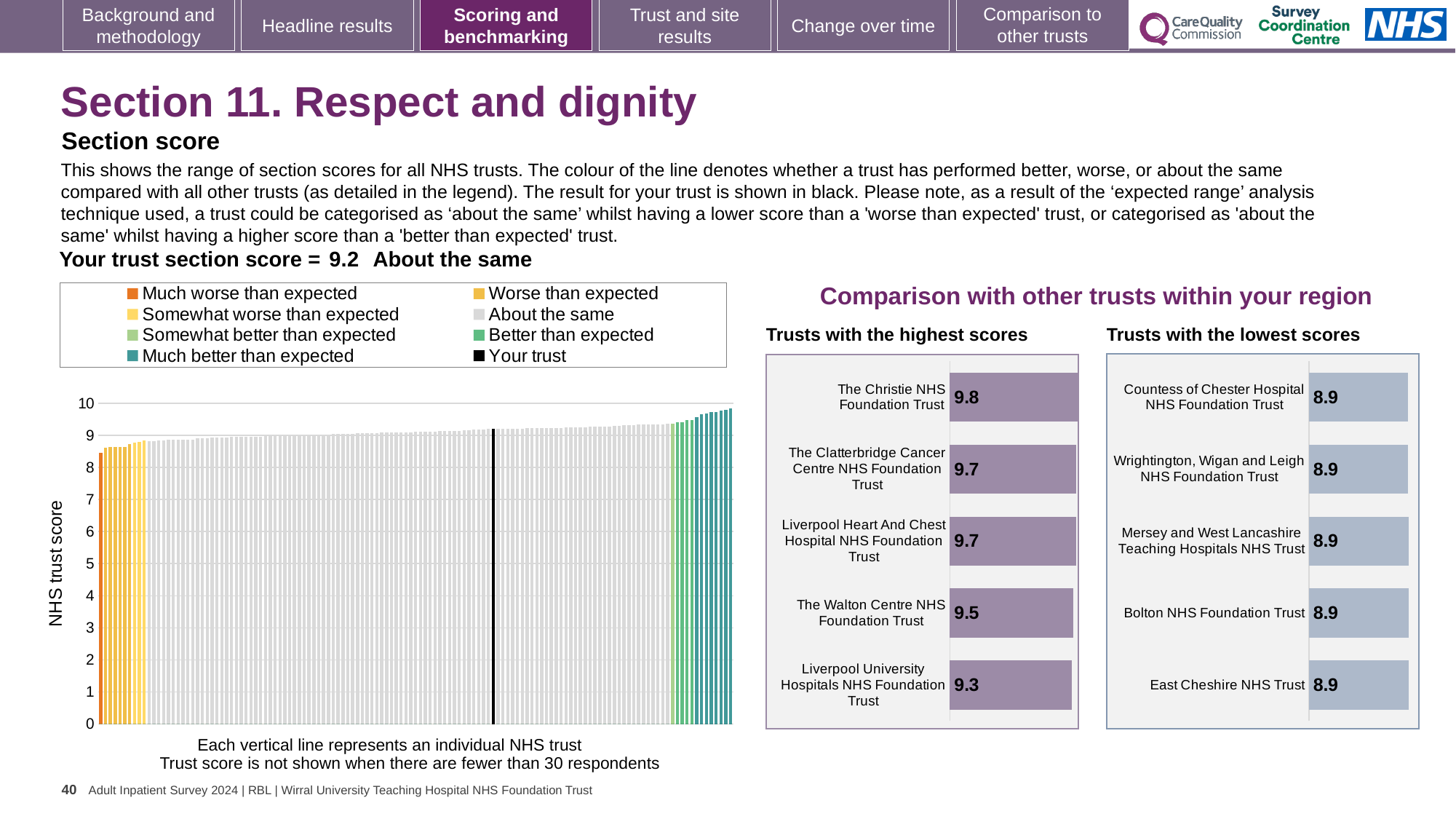
How many entries does the legend above the large chart on the left list? 8 In the 'Trusts with the highest scores' chart, which has the larger score: The Walton Centre NHS Foundation Trust or Liverpool University Hospitals NHS Foundation Trust? The Walton Centre NHS Foundation Trust How many trusts are shown in the 'Trusts with the lowest scores' chart? 5 In the 'Trusts with the highest scores' chart, what is the difference between the scores of The Christie NHS Foundation Trust and Liverpool University Hospitals NHS Foundation Trust? 0.5 On the large chart on the left, is the value of the lowest (orange) bar greater or less than 9? less According to the slide, what is your trust's section score for Respect and dignity? 9.2 In the 'Trusts with the highest scores' chart, which trust has the lowest score? Liverpool University Hospitals NHS Foundation Trust In the 'Trusts with the highest scores' chart, what is the score for The Christie NHS Foundation Trust? 9.8 In the 'Trusts with the lowest scores' chart, what is the score for Bolton NHS Foundation Trust? 8.9 In the 'Trusts with the highest scores' chart, which trust has the highest score? The Christie NHS Foundation Trust What kind of chart is the large chart on the left of the slide showing NHS trust scores? bar chart On the large chart on the left, what is the label on the vertical axis? NHS trust score